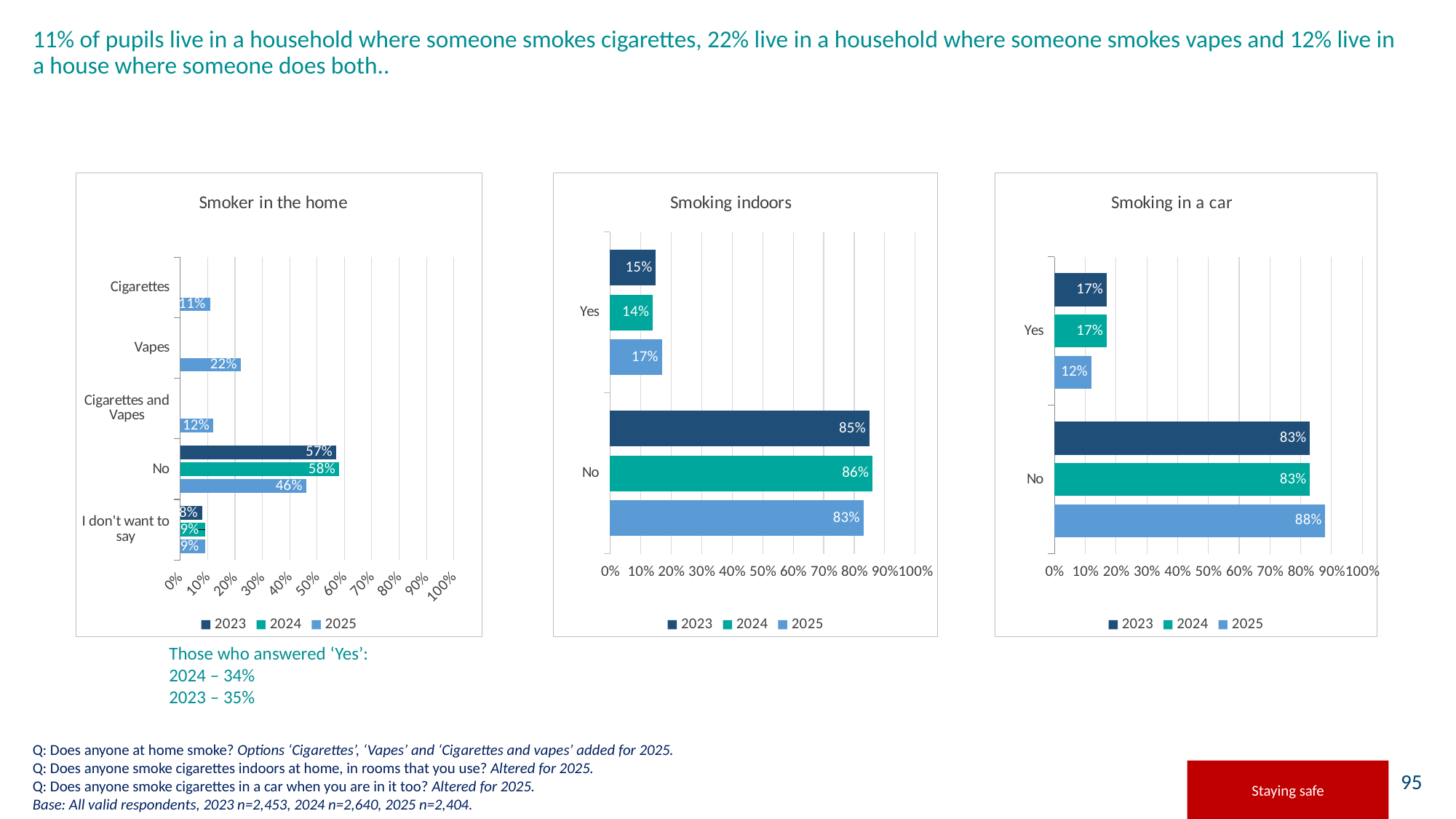
In the 'Smoking indoors' chart, what is the difference between the 2023 values for No and Yes? 70% In the 'Smoker in the home' chart, how many categories are shown on the vertical axis? 5 In the 'Smoking indoors' chart, which year has the highest value for No? 2024 In the 'Smoking in a car' chart, which year has the lowest value for Yes? 2025 In the 'Smoking in a car' chart, what is the 2025 value for No? 88% In the 'Smoking indoors' chart, what is the 2025 value for Yes? 17% In the 'Smoking in a car' chart, is the 2025 value for Yes larger or smaller than the 2023 value for Yes? smaller In the 'Smoker in the home' chart, what is the difference between the 2024 and 2025 values for No? 12% How many series does the legend of the 'Smoking in a car' chart list? 3 In the 'Smoker in the home' chart, what is the 2024 value for No? 58% In the 'Smoker in the home' chart, what is the 2025 value for Vapes? 22% What type of chart is the 'Smoking indoors' chart? bar chart